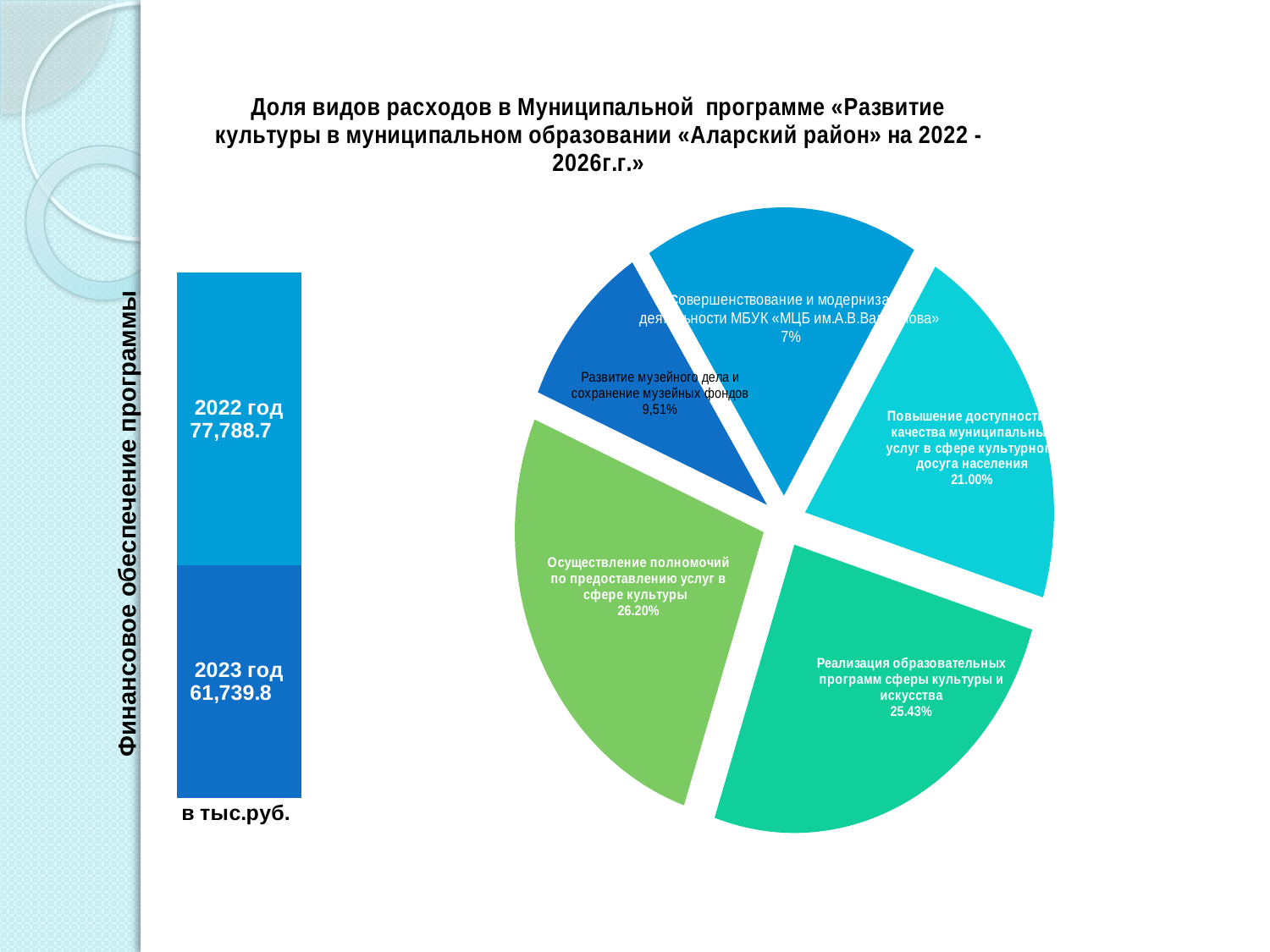
In the stacked bar on the left, what is the value for 2022 год? 77,788.7 In the pie chart, which share is larger: «Реализация образовательных программ сферы культуры и искусства» or «Повышение доступности и качества муниципальных услуг в сфере культурного досуга населения»? Реализация образовательных программ сферы культуры и искусства In the stacked bar on the left, what is the difference between the 2022 год and 2023 год values? 16,048.9 In the stacked bar on the left, what is the value for 2023 год? 61,739.8 In the pie chart, which category has the largest share? Осуществление полномочий по предоставлению услуг в сфере культуры How many slices does the pie chart have? 5 In the pie chart, what share is shown for «Повышение доступности и качества муниципальных услуг в сфере культурного досуга населения»? 21.00% In the pie chart, what is the difference in percentage points between «Осуществление полномочий по предоставлению услуг в сфере культуры» and «Реализация образовательных программ сферы культуры и искусства»? 0.77 In the pie chart, what share is shown for «Развитие музейного дела и сохранение музейных фондов»? 9,51% In the pie chart, what share is shown for «Осуществление полномочий по предоставлению услуг в сфере культуры»? 26.20% In what units are the values of the stacked bar on the left given? в тыс.руб. In the pie chart, what share is shown for «Реализация образовательных программ сферы культуры и искусства»? 25.43%